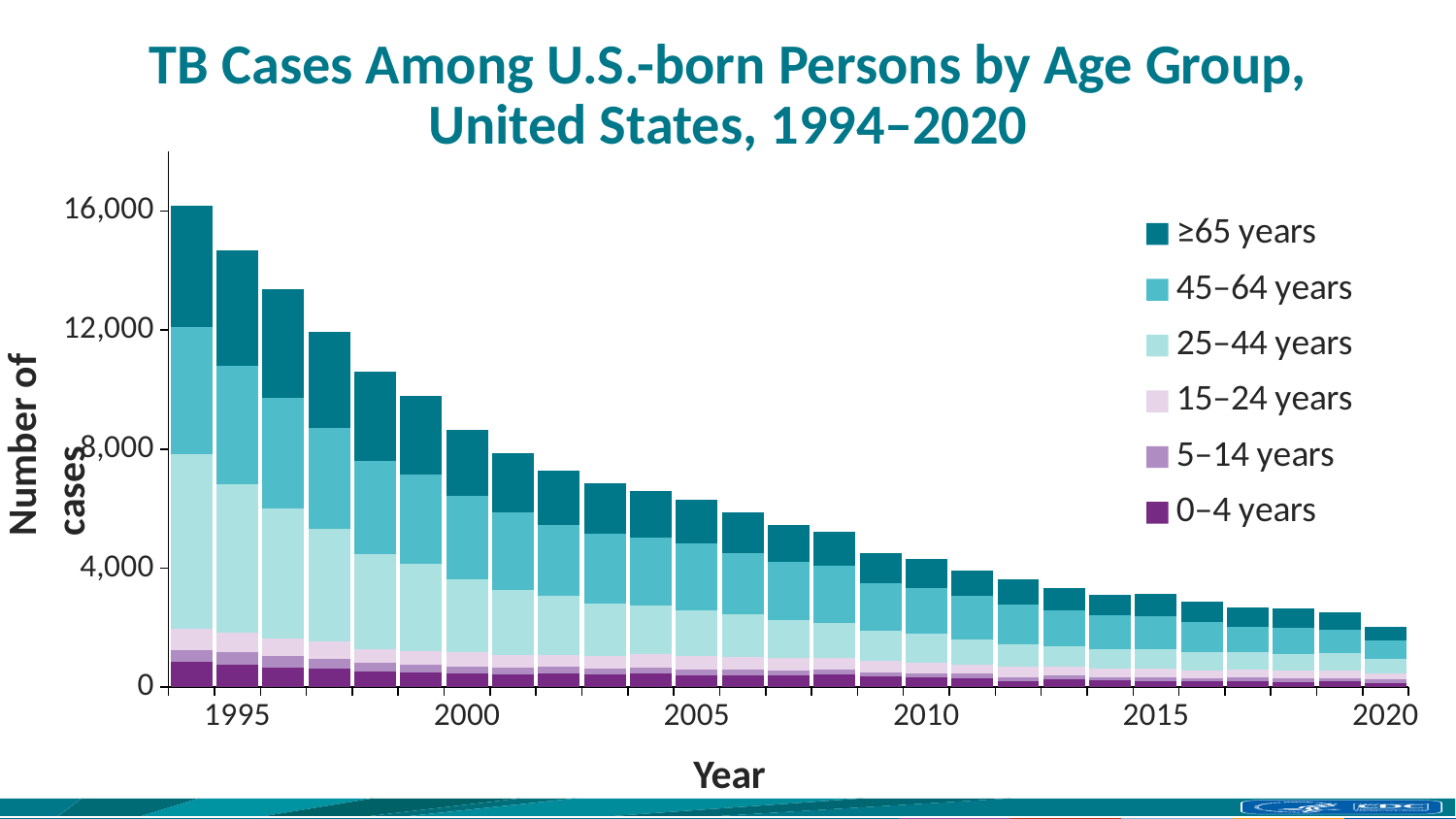
Which year has the lowest total number of TB cases? 2020 What kind of chart is shown on the slide? Stacked bar chart How many age-group series does the legend list? 6 Is the total number of cases in 2000 greater or less than 12,000? less Which year has the highest total number of TB cases? 1994 What is the label of the y-axis? Number of cases Is the total number of cases in 2020 greater or less than 4,000? less Do the total number of TB cases among U.S.-born persons rise or fall from 1994 to 2020? Fall Is the total number of cases in 2005 greater or less than 4,000? greater Which year has more total TB cases, 1995 or 2010? 1995 How many years (bars) are plotted in the chart? 27